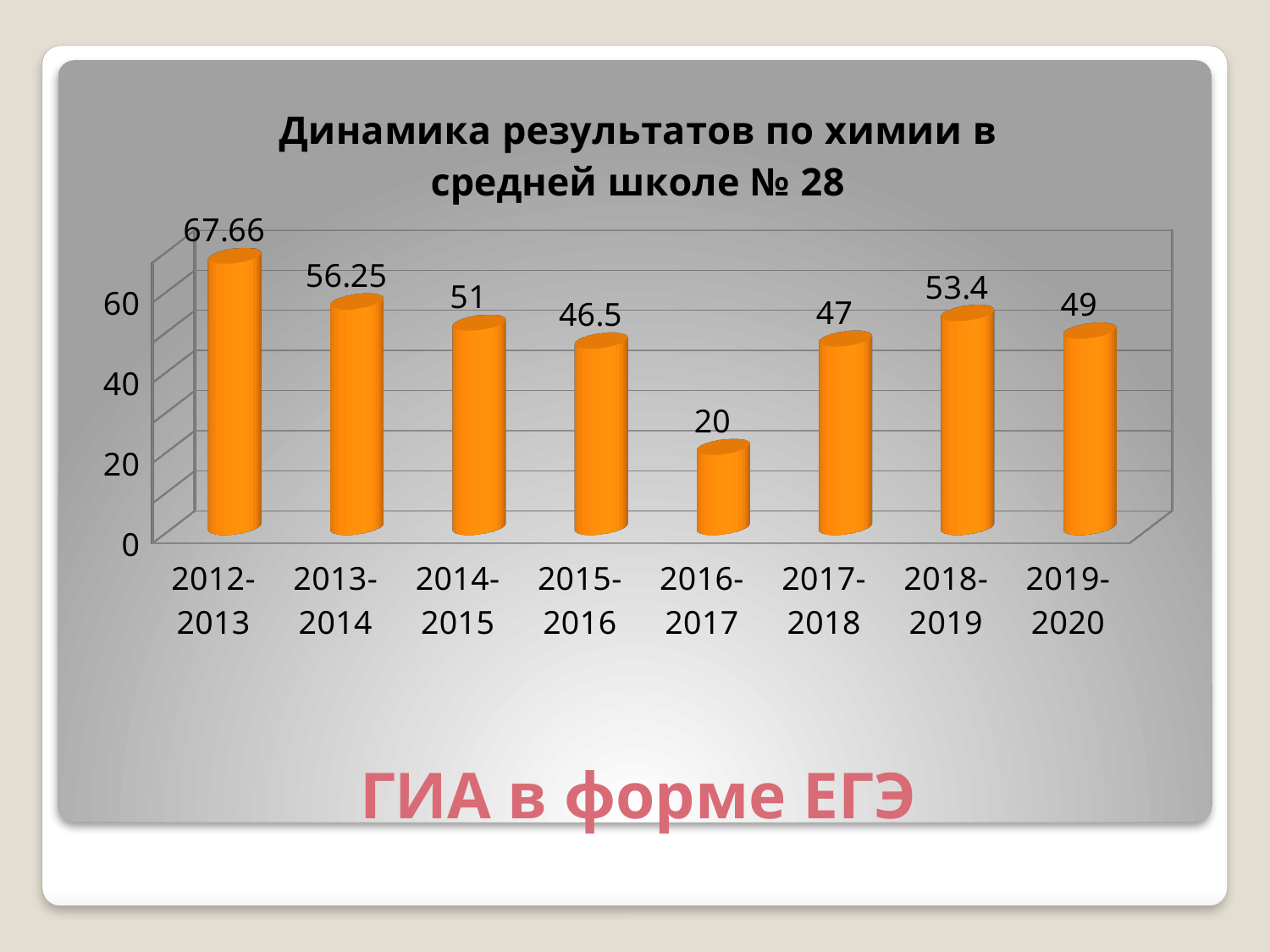
What is the difference between the values for 2013-2014 and 2014-2015? 5.25 Is the value for 2013-2014 greater or less than 40? greater What kind of chart is shown on the slide? bar chart Which is larger, the value for 2015-2016 or the value for 2017-2018? 2017-2018 Which school year has the highest value? 2012-2013 What is the value for 2012-2013? 67.66 What is the value for 2016-2017? 20 What is the title of the chart? Динамика результатов по химии в средней школе № 28 Which school year has the lowest value? 2016-2017 How many school years are shown on the chart? 8 What is the value for 2019-2020? 49 What is the value for 2018-2019? 53.4